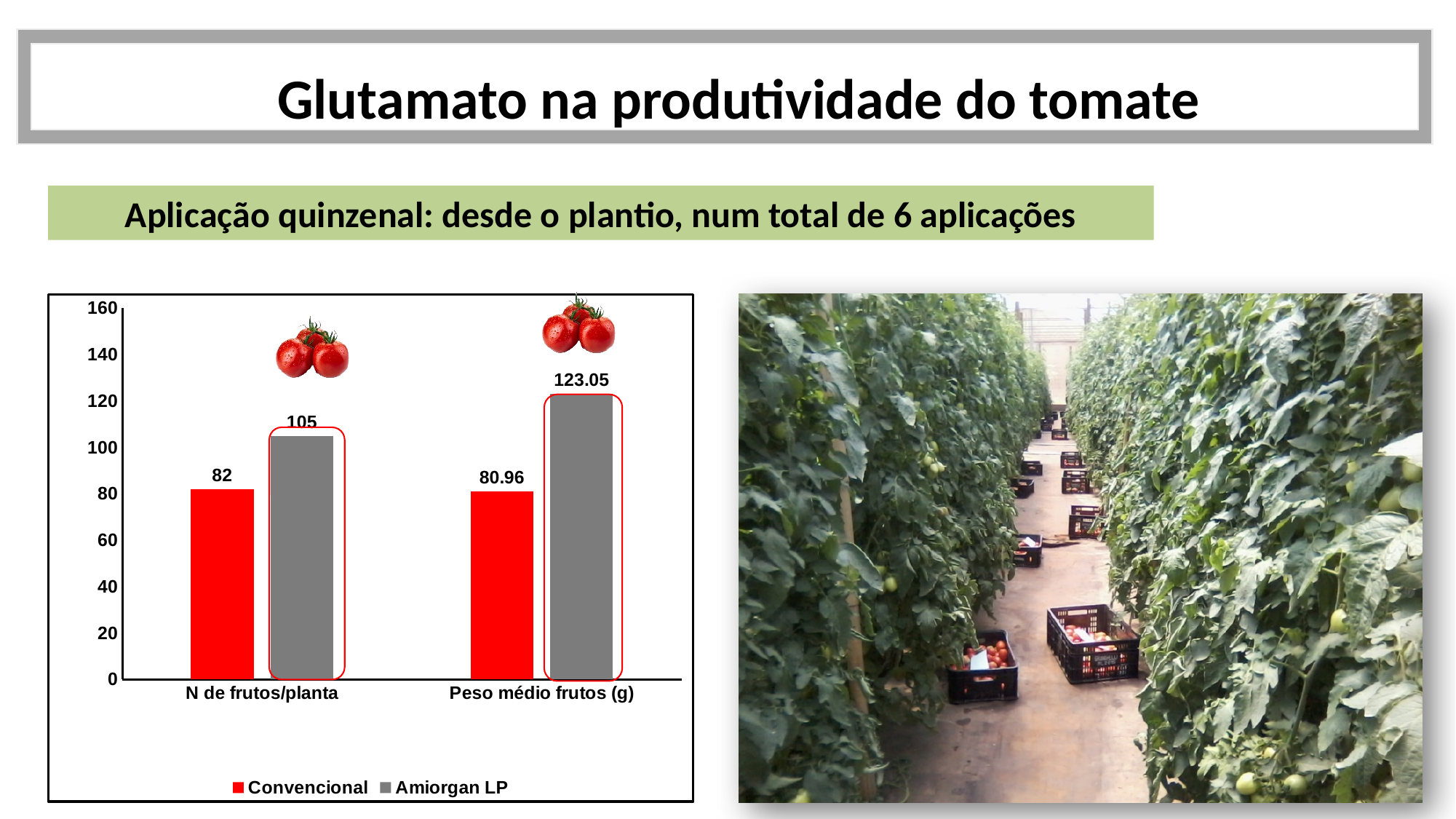
What is the value for Amiorgan LP in the Peso médio frutos (g) category? 123.05 Which series has the higher value in the Peso médio frutos (g) category? Amiorgan LP Which bar has the highest value in the chart? Amiorgan LP, Peso médio frutos (g) What is the value for Amiorgan LP in the N de frutos/planta category? 105 How many categories are shown on the x axis? 2 What is the difference between Amiorgan LP and Convencional in the Peso médio frutos (g) category? 42.09 What is the difference between Amiorgan LP and Convencional in the N de frutos/planta category? 23 What is the value for Convencional in the Peso médio frutos (g) category? 80.96 How many series does the legend list? 2 What is the value for Convencional in the N de frutos/planta category? 82 What kind of chart is shown on the slide? Bar chart Which bar has the lowest value in the chart? Convencional, Peso médio frutos (g)